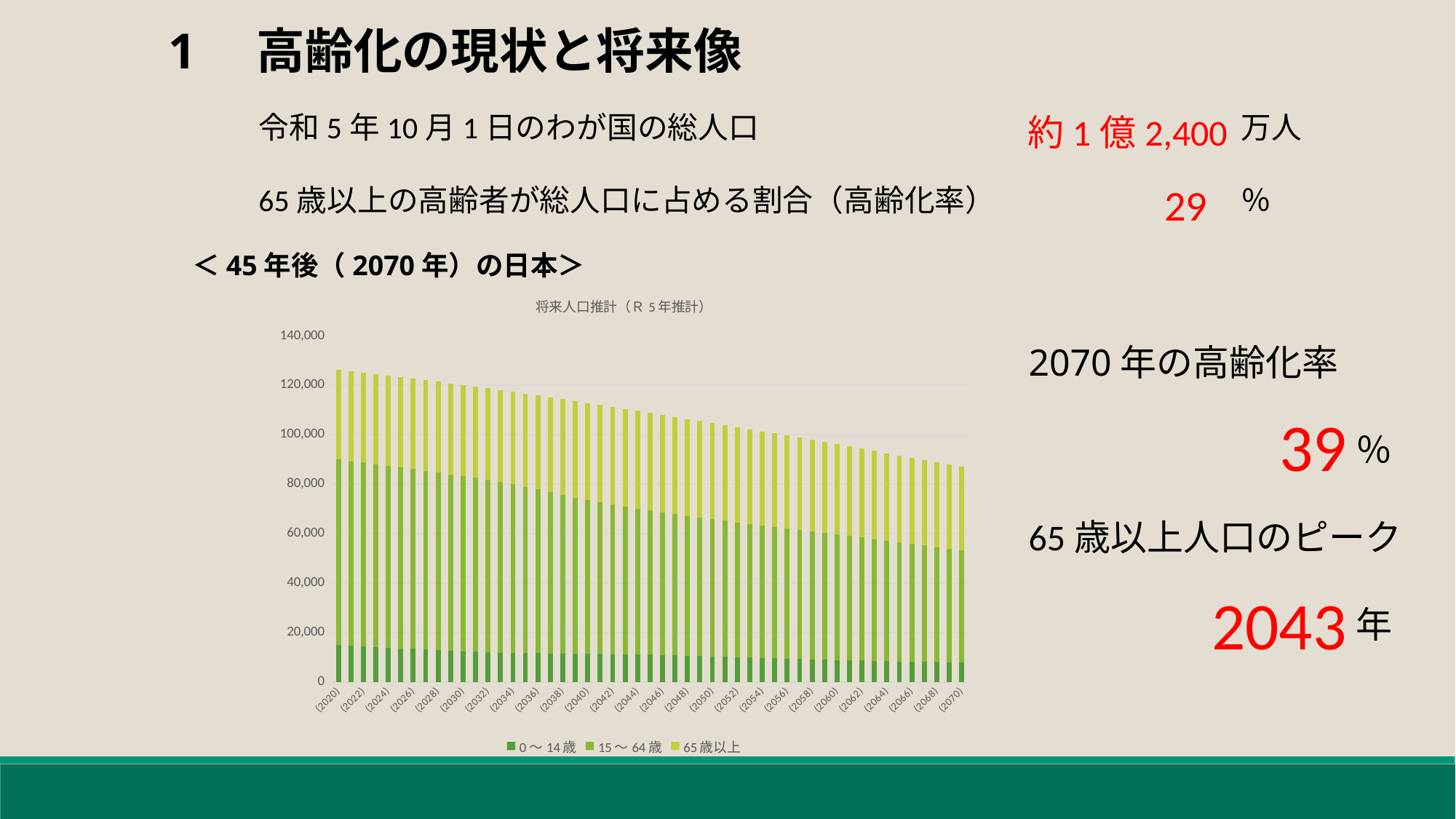
Is the total bar for 2070 greater or less than 80,000? greater Is the total bar for 2070 greater or less than 100,000? less Which year has the shortest total bar? 2070 What is the title of the chart? 将来人口推計（Ｒ５年推計） Is the 0～14歳 segment for 2020 greater or less than 20,000? less Does the total population shown by the bars rise or fall from 2020 to 2070? Fall Which total bar is larger, 2020 or 2070? 2020 How many series does the chart legend list? 3 Which year has the tallest total bar? 2020 What kind of chart is shown on the slide? Stacked bar chart What are the three series listed in the chart legend? 0～14歳, 15～64歳, 65歳以上